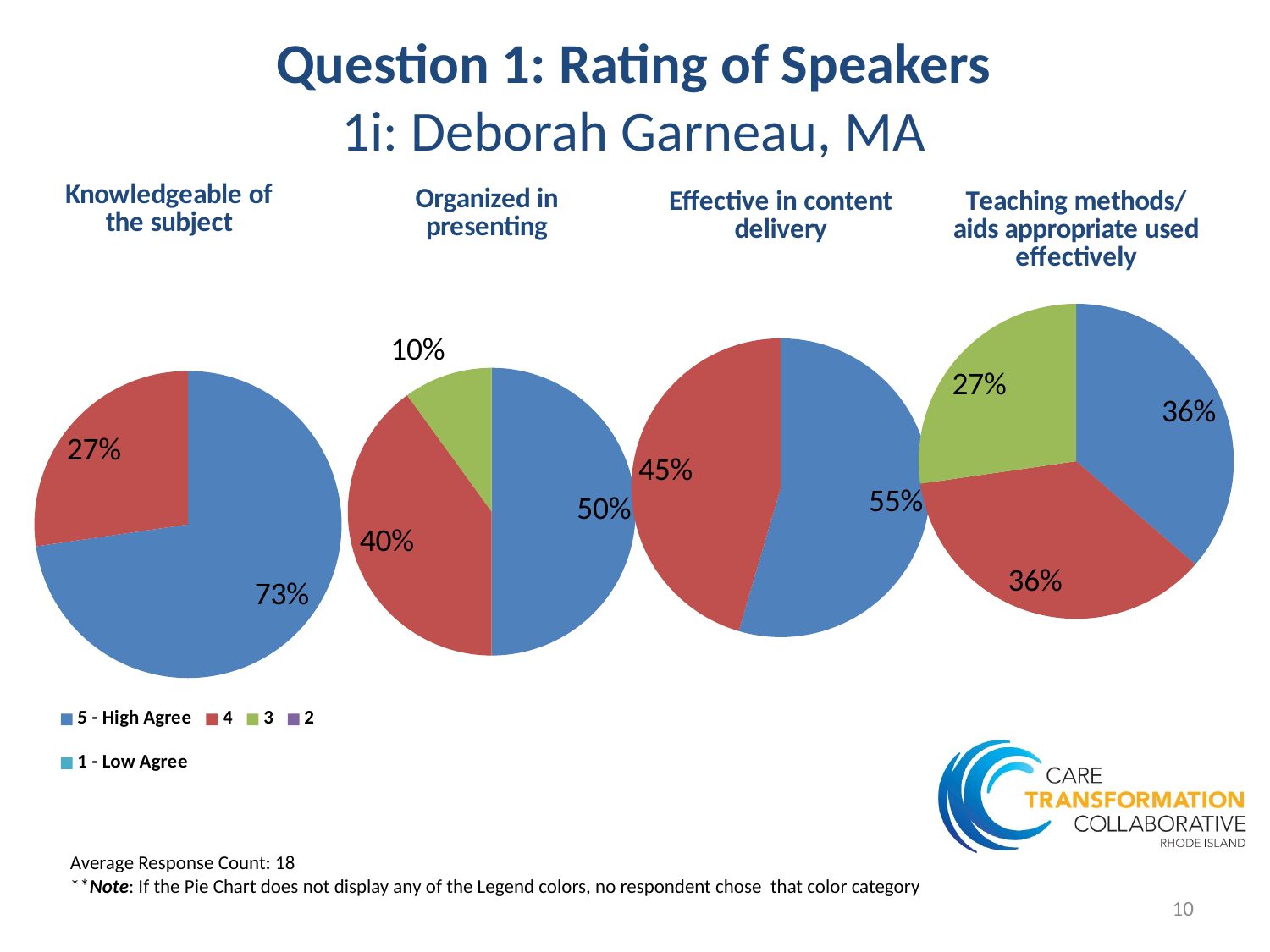
In the 'Teaching methods/aids appropriate used effectively' pie chart, what share of respondents chose '3'? 27% In the 'Effective in content delivery' pie chart, what share of respondents chose '5 - High Agree'? 55% How many entries does the legend list? 5 In the 'Knowledgeable of the subject' pie chart, what share of respondents chose '4'? 27% In the 'Knowledgeable of the subject' pie chart, what share of respondents chose '5 - High Agree'? 73% In the 'Effective in content delivery' pie chart, which rating has the largest slice? 5 - High Agree In the 'Organized in presenting' pie chart, which rating has the smallest slice? 3 How many slices does the 'Teaching methods/aids appropriate used effectively' pie chart have? 3 In the 'Organized in presenting' pie chart, what share of respondents chose '4'? 40% In the 'Knowledgeable of the subject' pie chart, what is the difference between the '5 - High Agree' share and the '4' share? 46% In the 'Organized in presenting' pie chart, what share of respondents chose '3'? 10% In the 'Organized in presenting' pie chart, which is larger: the '5 - High Agree' slice or the '4' slice? 5 - High Agree